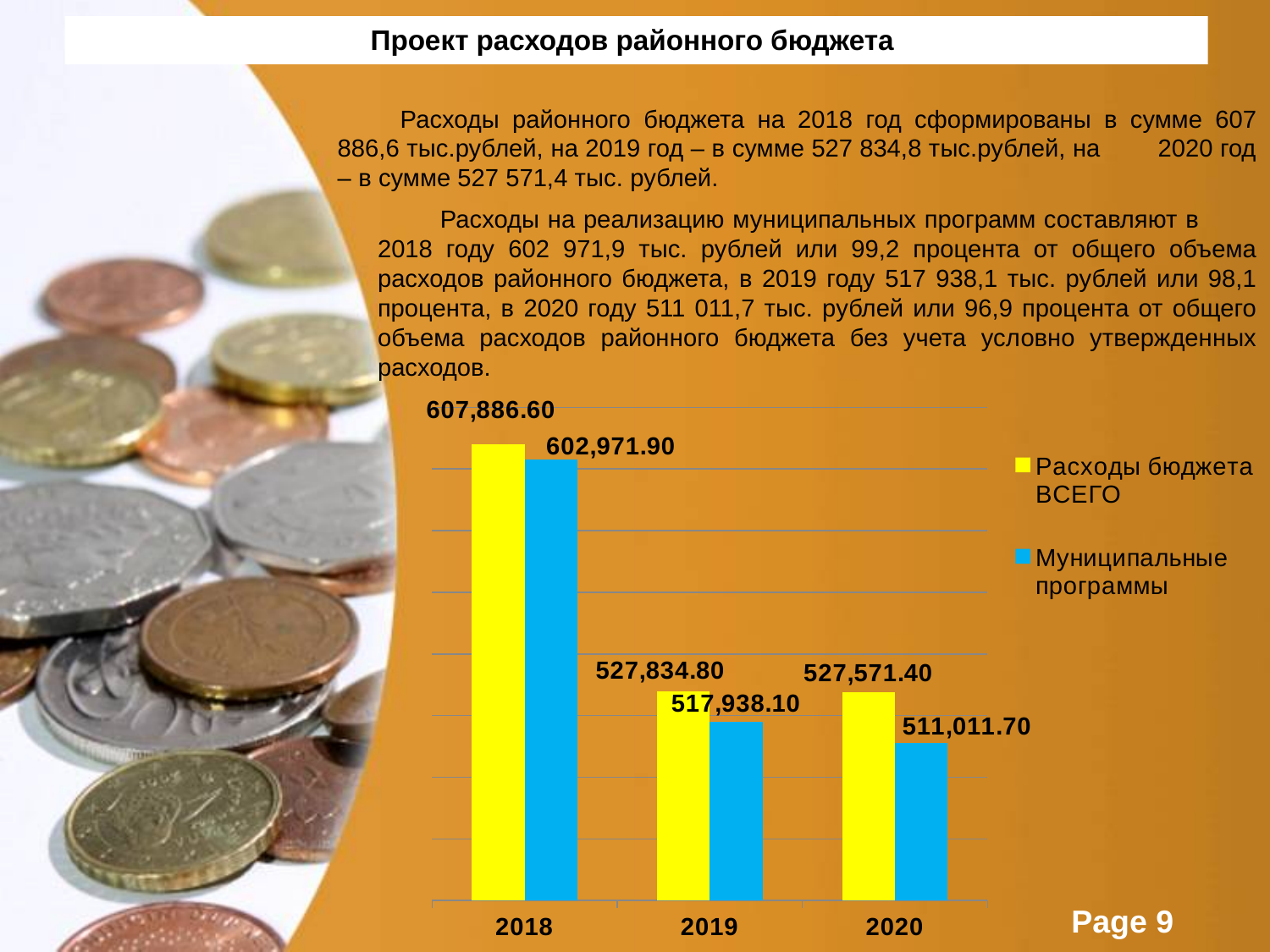
What is the value of Расходы бюджета ВСЕГО for 2018? 607,886.60 What is the difference between Расходы бюджета ВСЕГО and Муниципальные программы in 2020? 16,559.70 Which year has the highest value for Расходы бюджета ВСЕГО? 2018 What is the difference between Расходы бюджета ВСЕГО and Муниципальные программы in 2018? 4,914.70 Which is larger: Муниципальные программы in 2018 or Муниципальные программы in 2019? 2018 How many years are shown on the x axis of the chart? 3 Which year has the lowest value for Муниципальные программы? 2020 What is the value of Муниципальные программы for 2019? 517,938.10 What is the value of Муниципальные программы for 2020? 511,011.70 What kind of chart is shown on the slide? Bar chart How many series does the chart legend list? 2 What is the value of Расходы бюджета ВСЕГО for 2020? 527,571.40